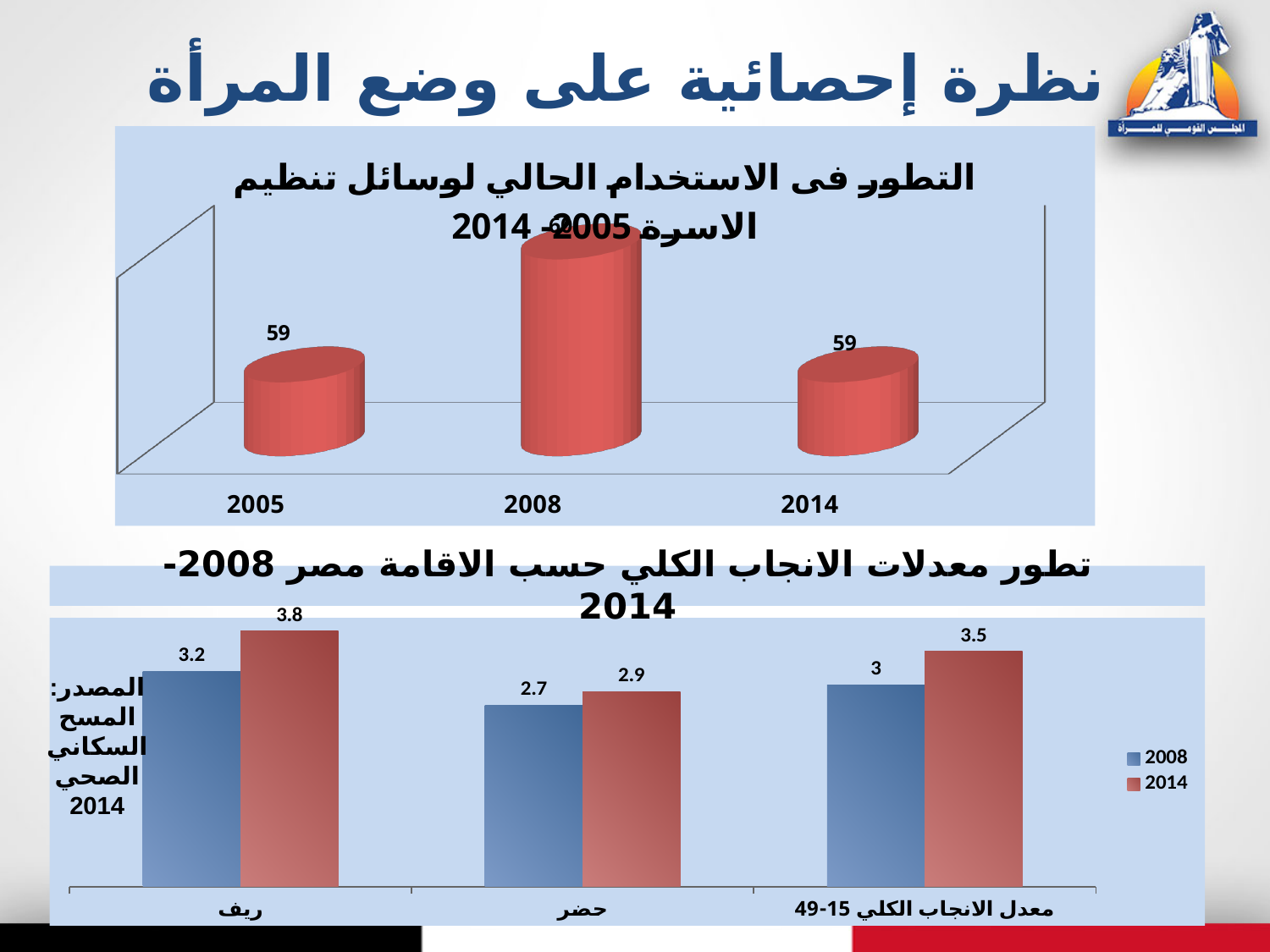
In the bottom chart, which category has the lowest 2008 value? حضر In the bottom chart, what is the 2014 value for معدل الانجاب الكلي 15-49? 3.5 How many categories are shown on the x axis of the top chart? 3 In the bottom chart, what is the 2008 value for حضر? 2.7 In the top chart, what is the value for 2005? 59 In the bottom chart, what is the difference between the 2014 and 2008 values for ريف? 0.6 What kind of chart is the bottom chart? bar chart In the bottom chart, what is the 2014 value for ريف? 3.8 How many series does the legend of the bottom chart list? 2 In the bottom chart, is the 2008 value for ريف larger or smaller than the 2014 value for ريف? smaller In the top chart, which year has the highest bar? 2008 In the top chart, what is the value for 2014? 59